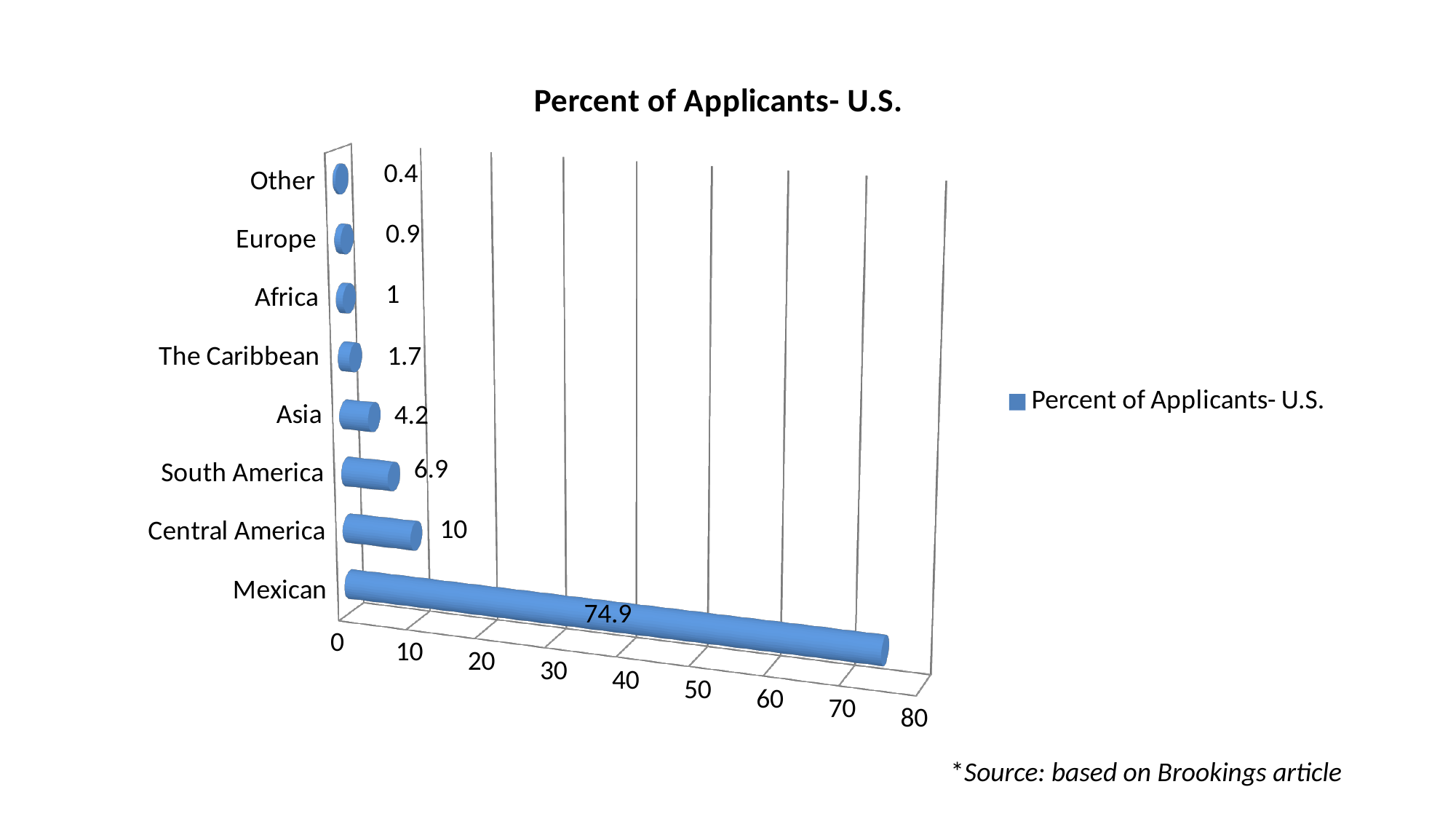
Which category has the highest value? Mexican What is the title of the chart? Percent of Applicants- U.S. What is the value for Central America? 10 What is the value for Asia? 4.2 What is the difference between the values for Central America and South America? 3.1 Which is larger, the value for The Caribbean or the value for Africa? The Caribbean What is the value for Other? 0.4 How many categories are shown in the chart? 8 What is the value for Mexican? 74.9 What kind of chart is shown? bar chart Is the value for Mexican greater or less than 70? greater Which category has the lowest value? Other